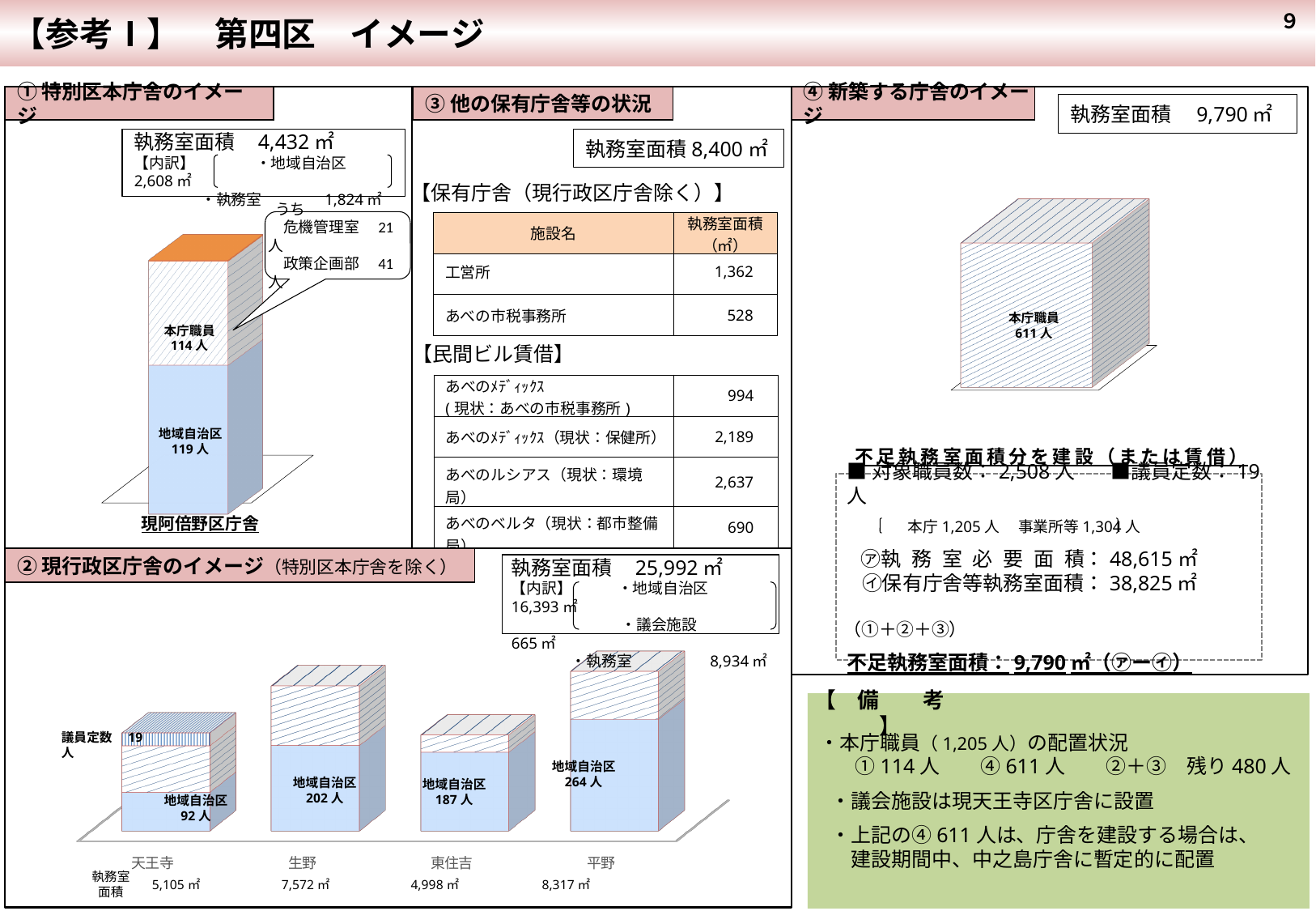
In the ② 現行政区庁舎のイメージ chart, what is the 地域自治区 value for 平野? 264 人 In the ② 現行政区庁舎のイメージ chart, which ward has the largest 執務室面積? 平野 In the ② 現行政区庁舎のイメージ chart, which ward has the lowest 地域自治区 value? 天王寺 In the ① 特別区本庁舎のイメージ chart, what is the 本庁職員 value? 114 人 In the ② 現行政区庁舎のイメージ chart, which ward has the smallest 執務室面積? 東住吉 In the ④ 新築する庁舎のイメージ chart, what is the 本庁職員 value? 611 人 In the ② 現行政区庁舎のイメージ chart, which ward has the highest 地域自治区 value? 平野 In the ② 現行政区庁舎のイメージ chart, what is the 執務室面積 for 生野? 7,572 ㎡ In the ② 現行政区庁舎のイメージ chart, which has the larger 地域自治区 value, 生野 or 東住吉? 生野 In the ② 現行政区庁舎のイメージ chart, what is the 議員定数 shown for 天王寺? 19 人 In the ② 現行政区庁舎のイメージ chart, how many wards are shown? 4 In the ② 現行政区庁舎のイメージ chart, what is the difference between the 地域自治区 values for 平野 and 天王寺? 172 人